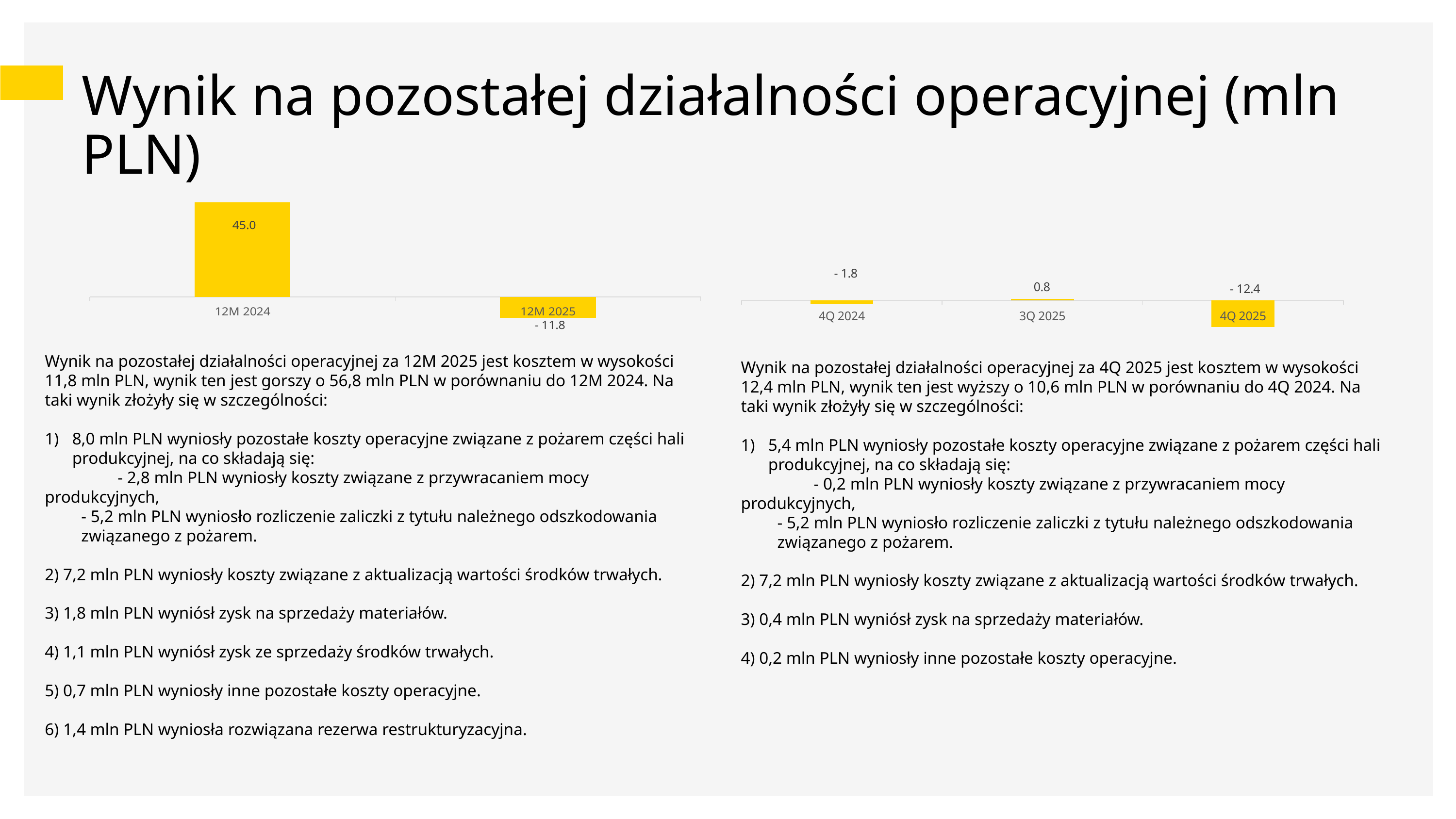
In the right chart, which period has the highest value? 3Q 2025 In the left chart, what is the value for 12M 2024? 45.0 In the right chart, what is the value for 4Q 2024? -1.8 How many periods are shown in the right chart? 3 In the right chart, what is the value for 4Q 2025? -12.4 In the right chart, what is the value for 3Q 2025? 0.8 In the right chart, which period has the lowest value? 4Q 2025 What type of chart is the left chart? Bar chart In the right chart, what is the difference between the values for 4Q 2024 and 4Q 2025? 10.6 In the left chart, what is the value for 12M 2025? -11.8 In the left chart, what is the difference between the values for 12M 2024 and 12M 2025? 56.8 In the right chart, which is larger, the value for 4Q 2024 or the value for 4Q 2025? 4Q 2024